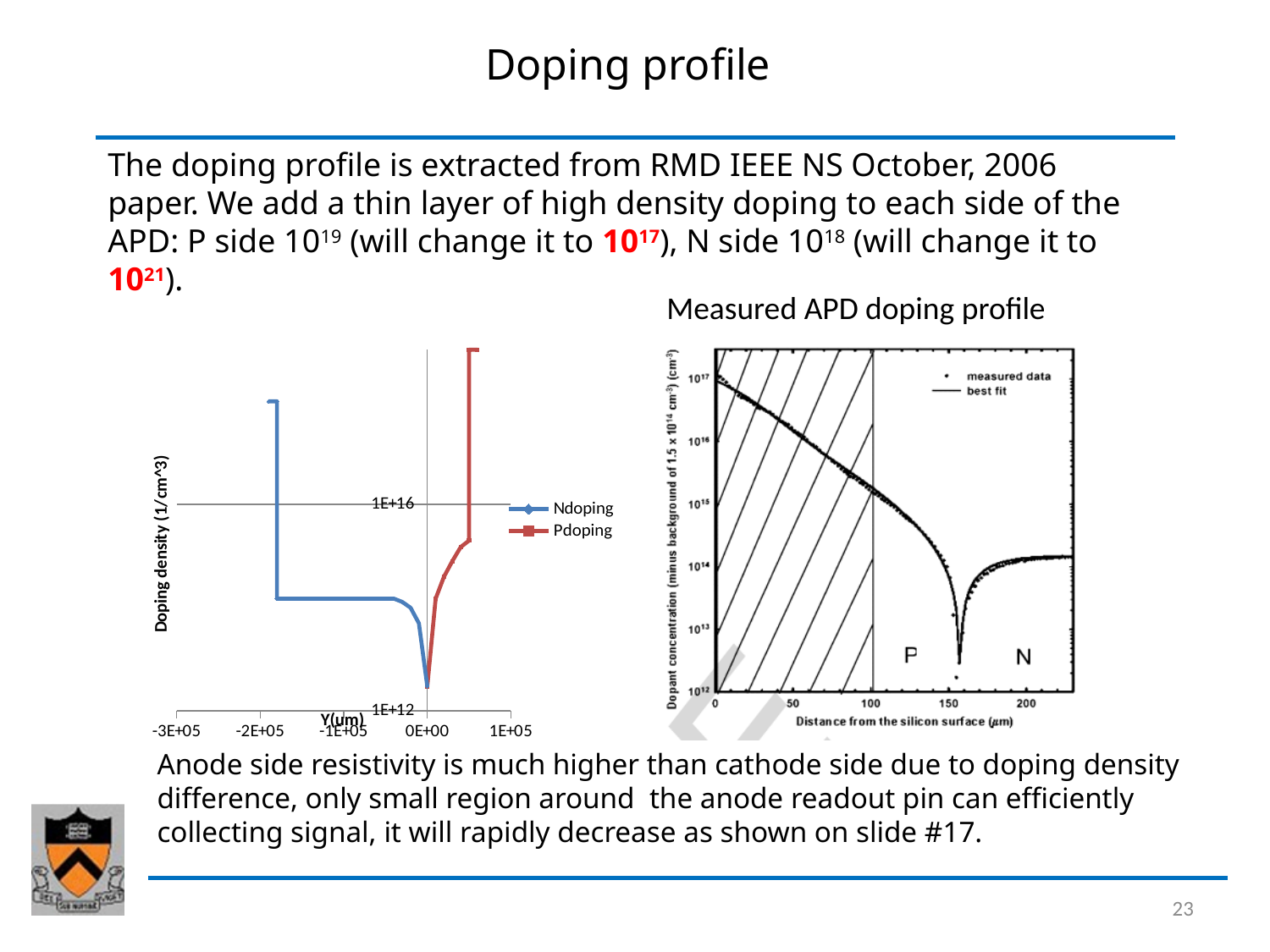
In the left chart, what colour is the Ndoping series drawn in? blue In the 'Measured APD doping profile' chart, is the dopant concentration at a distance of 200 μm greater or less than 10^15? less In the 'Measured APD doping profile' chart, does the dopant concentration rise or fall as distance increases from 0 to 100 μm? fall In the left chart, is the flat Ndoping level between Y = -2E+05 and 0E+00 greater or less than 1E+16? less In the left chart, is the peak value of the Ndoping series near Y = -2E+05 greater or less than 1E+16? greater What are the two legend entries of the left chart? Ndoping, Pdoping How many series does the legend of the 'Measured APD doping profile' chart list? 2 What kind of chart is the left chart showing Ndoping and Pdoping? line chart How many series does the legend of the left chart list? 2 In the left chart, which series is plotted at negative values of Y(um)? Ndoping